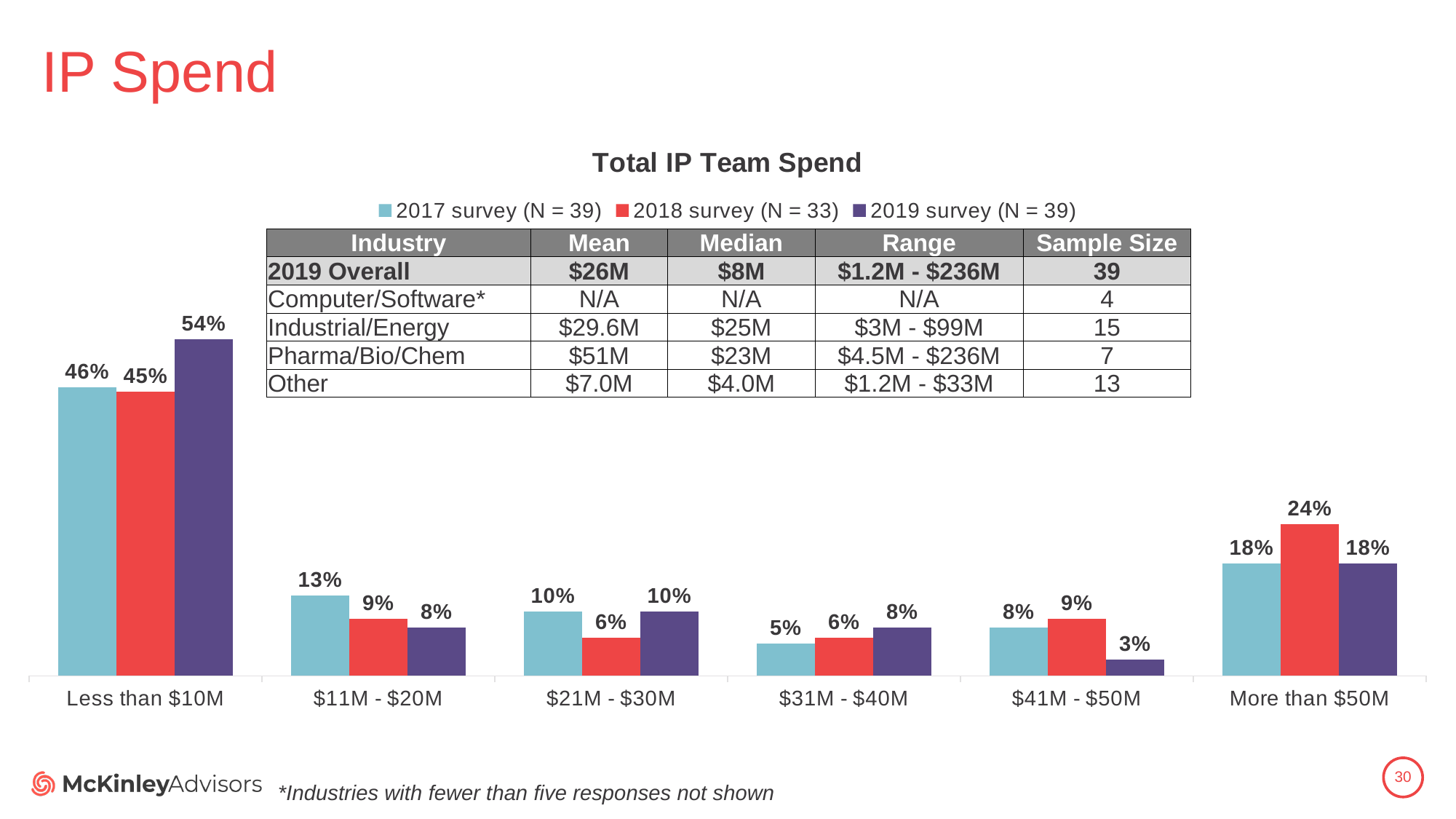
What is the difference between the 2019 survey and 2017 survey values for 'Less than $10M'? 8% How many series does the legend list? 3 What is the title of the chart? Total IP Team Spend For the '$41M - $50M' category, which is larger: the 2018 survey value or the 2019 survey value? 2018 survey What is the sample size (N) for the 2018 survey shown in the legend? 33 What kind of chart is shown on the slide? Bar chart What is the 2018 survey value for the 'More than $50M' category? 24% Which category has the lowest value in the 2019 survey series? $41M - $50M What is the 2017 survey value for the '$11M - $20M' category? 13% What is the 2019 survey value for the 'Less than $10M' category? 54% How many spend categories are shown on the x axis? 6 Which category has the highest value in the 2019 survey series? Less than $10M